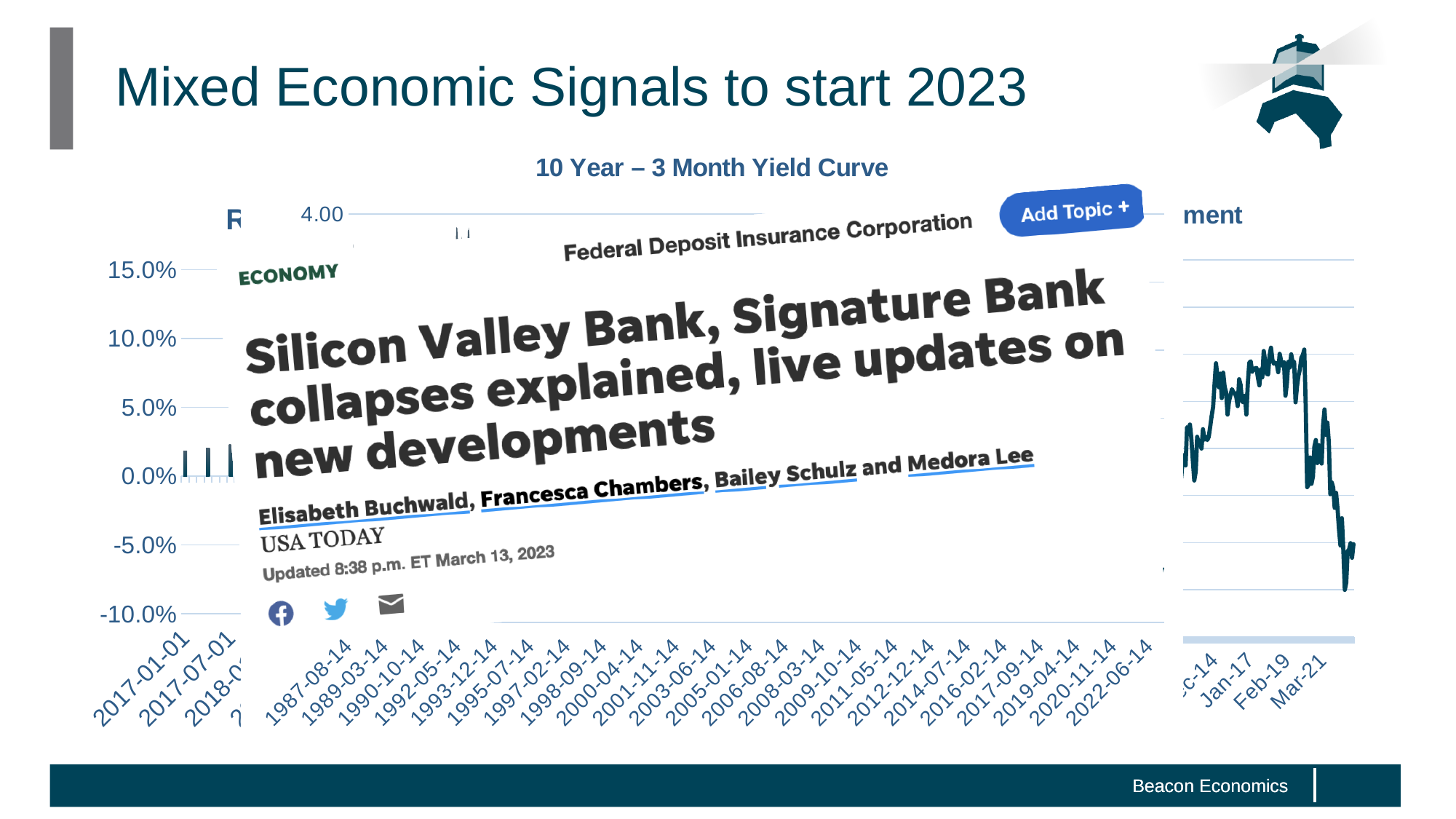
In the chart on the right of the slide, does the line rise or fall between Feb-19 and Mar-21? fall What is the title of the middle chart on the slide? 10 Year – 3 Month Yield Curve What kind of chart is the chart on the right of the slide, with x-axis labels Jan-17, Feb-19 and Mar-21? line chart In the 10 Year – 3 Month Yield Curve chart, what is the last date label shown on the x axis? 2022-06-14 What kind of chart is the chart on the left of the slide, with the y axis running from -10.0% to 15.0%? bar chart